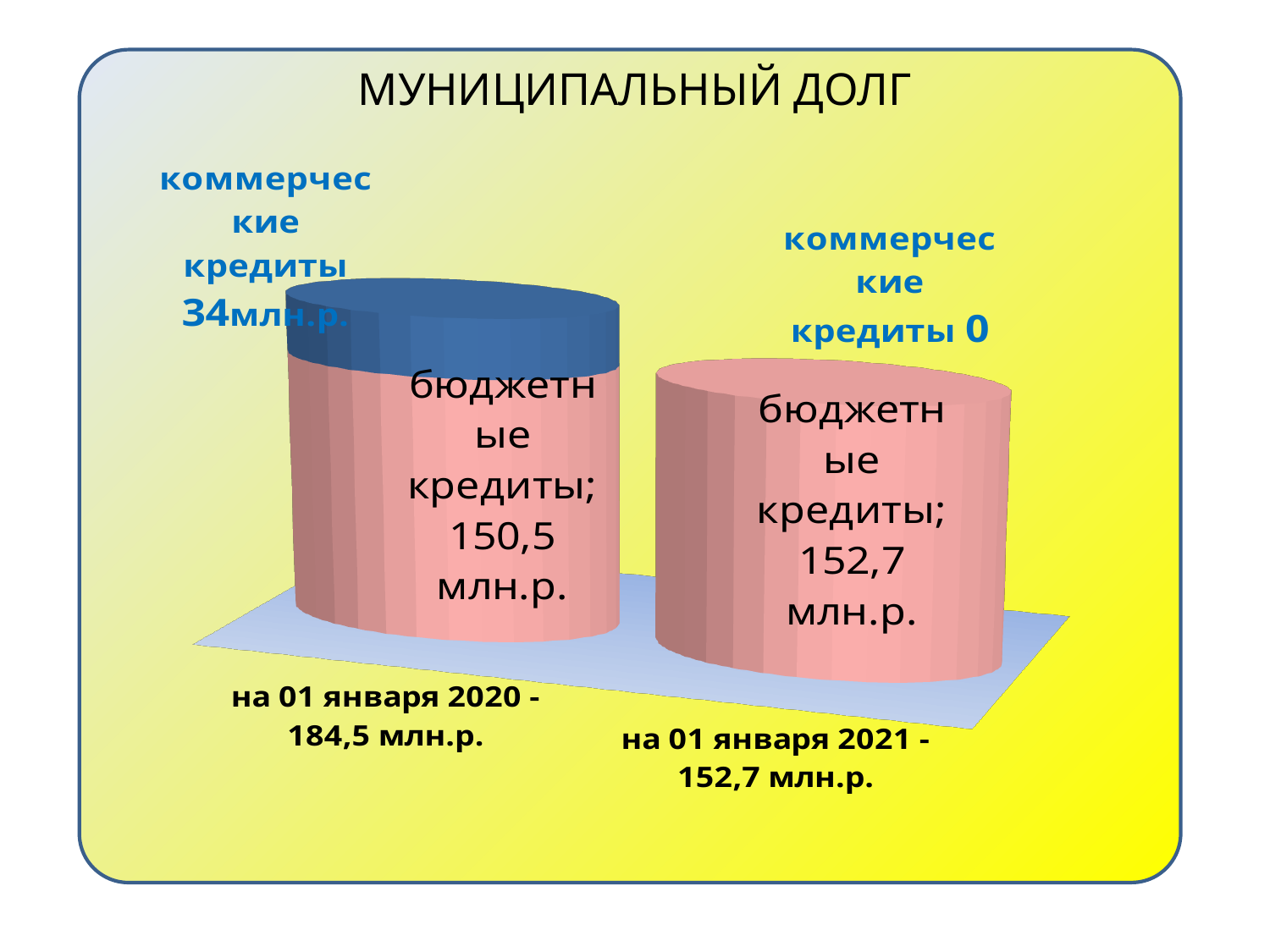
By how much did the total municipal debt decrease from 01 января 2020 to 01 января 2021? 31,8 млн.р. What is the value of коммерческие кредиты on 01 января 2020? 34 млн.р. What is the total municipal debt on 01 января 2021? 152,7 млн.р. What is the total municipal debt on 01 января 2020? 184,5 млн.р. What is the value of коммерческие кредиты on 01 января 2021? 0 Which colour represents коммерческие кредиты on the chart? blue What is the value of бюджетные кредиты on 01 января 2020? 150,5 млн.р. What kind of chart is shown on the slide? bar chart What is the title of the chart? МУНИЦИПАЛЬНЫЙ ДОЛГ Which date has the higher total municipal debt, 01 января 2020 or 01 января 2021? 01 января 2020 How many categories (dates) are shown on the chart? 2 What is the value of бюджетные кредиты on 01 января 2021? 152,7 млн.р.